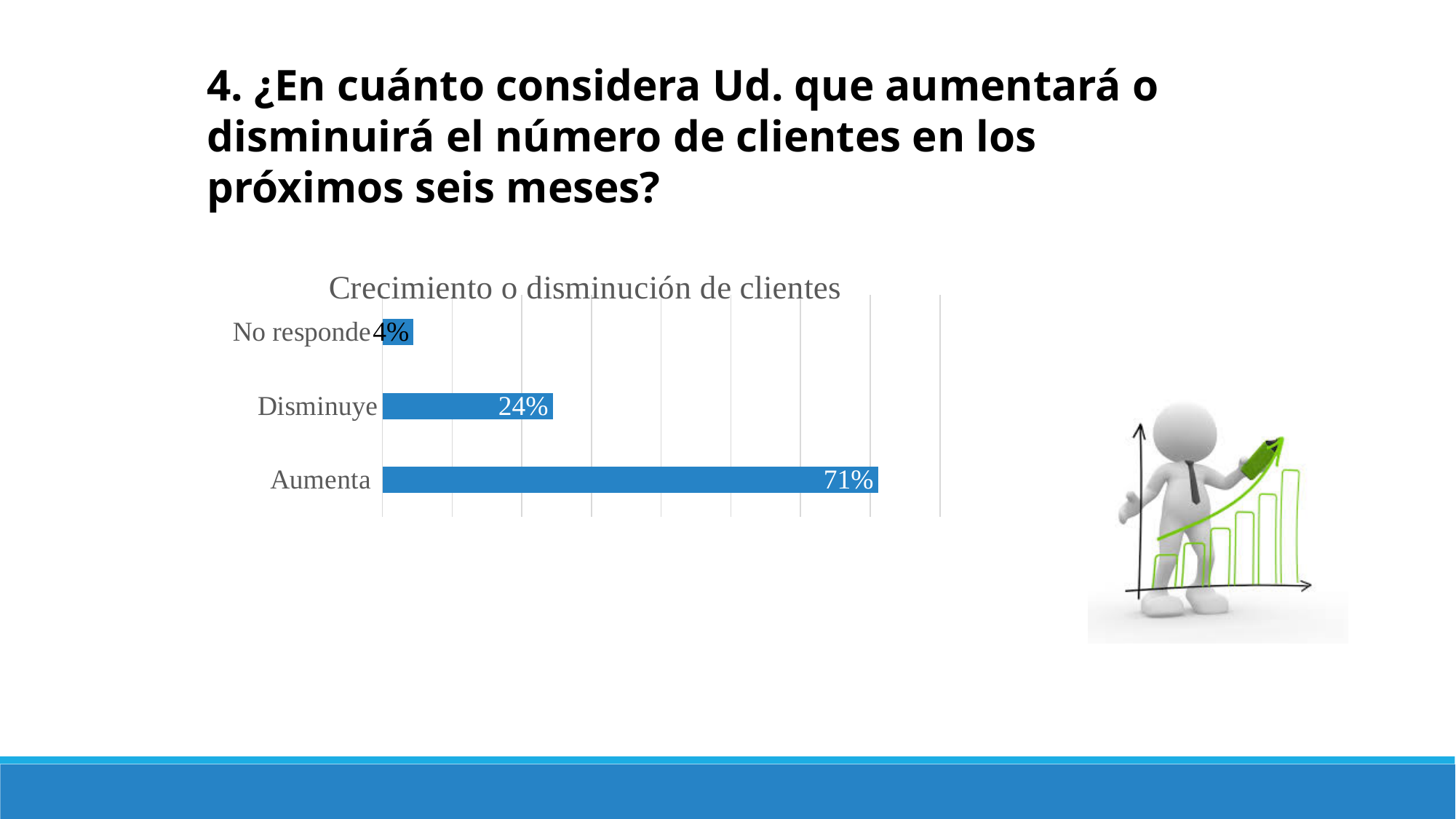
What is the value for Disminuye? 24% What is the value for No responde? 4% Which category has the highest value? Aumenta Which is larger, the value for Disminuye or the value for No responde? Disminuye What is the value for Aumenta? 71% What kind of chart is shown on the slide? Bar chart How many categories are shown in the chart? 3 Which category has the lowest value? No responde What is the difference between the values for Aumenta and Disminuye? 47% What colour are the bars in the chart? Blue What is the title of the chart? Crecimiento o disminución de clientes What is the difference between the values for Disminuye and No responde? 20%